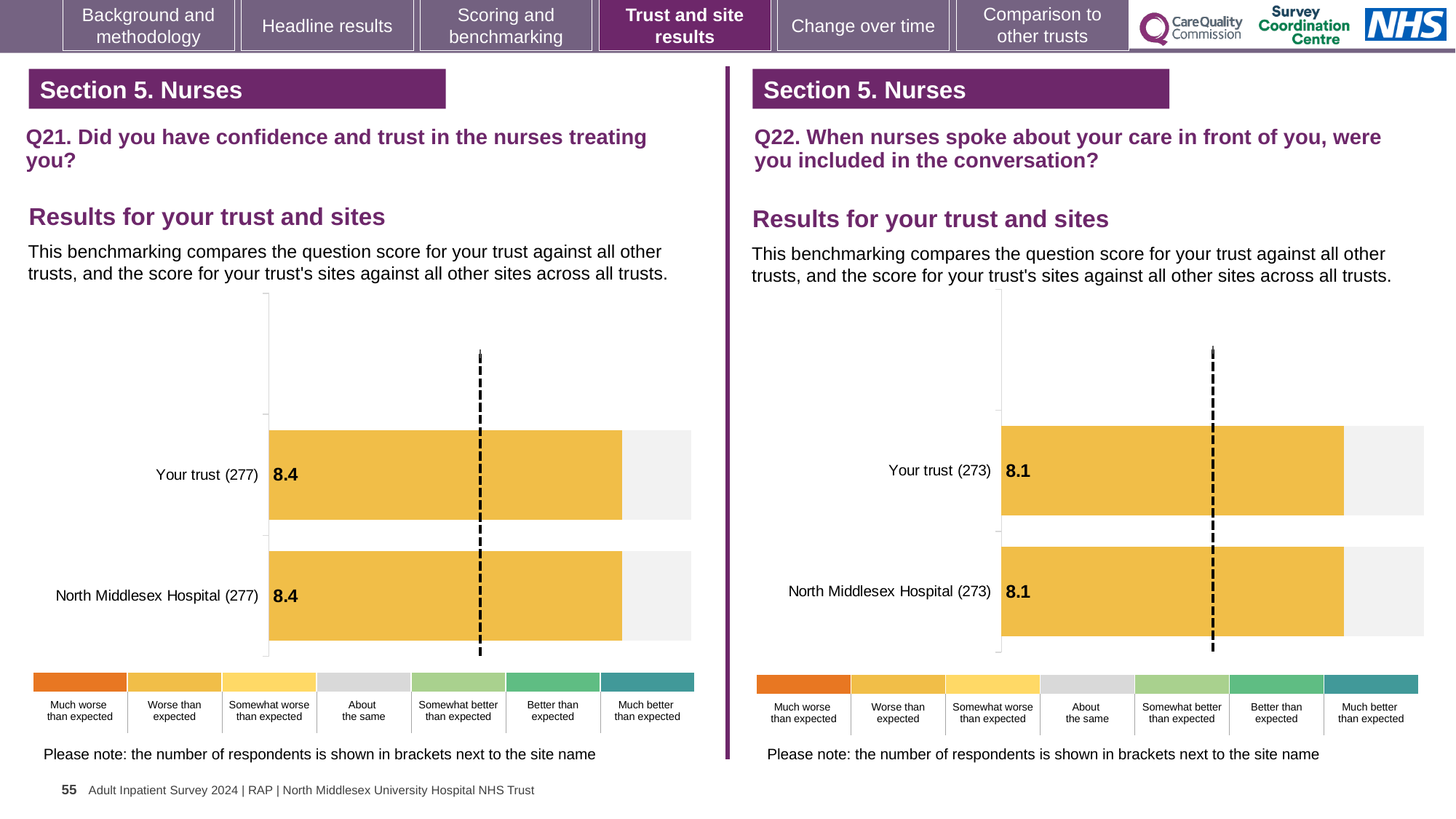
In the Q22 chart on the right, how many respondents are shown in brackets next to North Middlesex Hospital? 273 In the Q21 chart on the left, what is the score for Your trust? 8.4 In the Q22 chart on the right, what is the difference between the score for Your trust and the score for North Middlesex Hospital? 0 Is the score for Your trust in the Q21 chart on the left larger than, smaller than, or equal to the score for Your trust in the Q22 chart on the right? Larger How many bars are plotted in the Q22 chart on the right? 2 In the Q21 chart on the left, what is the difference between the score for Your trust and the score for North Middlesex Hospital? 0 How many bars are plotted in the Q21 chart on the left? 2 In the Q22 chart on the right, what is the score for North Middlesex Hospital? 8.1 In the Q21 chart on the left, how many respondents are shown in brackets next to Your trust? 277 What kind of chart is used in the Q21 chart on the left? Bar chart In the Q22 chart on the right, what is the score for Your trust? 8.1 In the Q21 chart on the left, what is the score for North Middlesex Hospital? 8.4